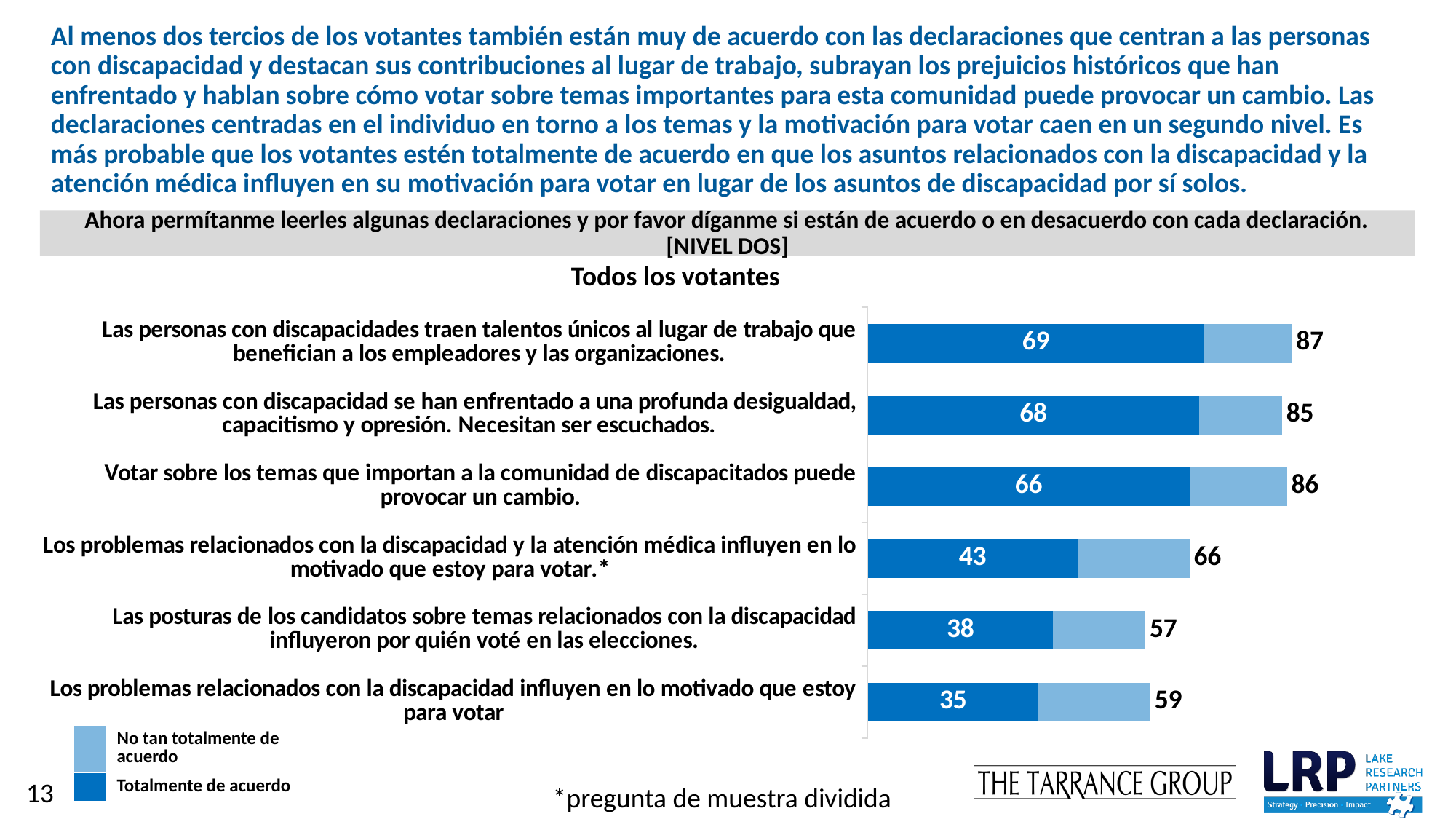
Which statement has the highest "Totalmente de acuerdo" value? Las personas con discapacidades traen talentos únicos al lugar de trabajo que benefician a los empleadores y las organizaciones. Which statement has the lowest total agreement value? Las posturas de los candidatos sobre temas relacionados con la discapacidad influyeron por quién voté en las elecciones. What type of chart is shown on the slide? Stacked horizontal bar chart What is the "Totalmente de acuerdo" value for the statement "Los problemas relacionados con la discapacidad influyen en lo motivado que estoy para votar"? 35 Which is larger: the "Totalmente de acuerdo" value for the statement about candidates' positions influencing who they voted for, or the one about disability issues influencing voting motivation? Candidates' positions (38) Which legend entry is represented by the dark blue colour? Totalmente de acuerdo What is the total agreement value for the statement "Votar sobre los temas que importan a la comunidad de discapacitados puede provocar un cambio."? 86 How many series does the legend list? 2 What percentage of all voters totally agree ("Totalmente de acuerdo") that people with disabilities bring unique talents to the workplace? 69 How many statements are shown in the chart? 6 What is the difference between the total agreement (66) and the "Totalmente de acuerdo" value (43) for the statement about disability and health care issues influencing voting motivation? 23 What is the total agreement value shown for the statement "Las personas con discapacidad se han enfrentado a una profunda desigualdad, capacitismo y opresión. Necesitan ser escuchados."? 85